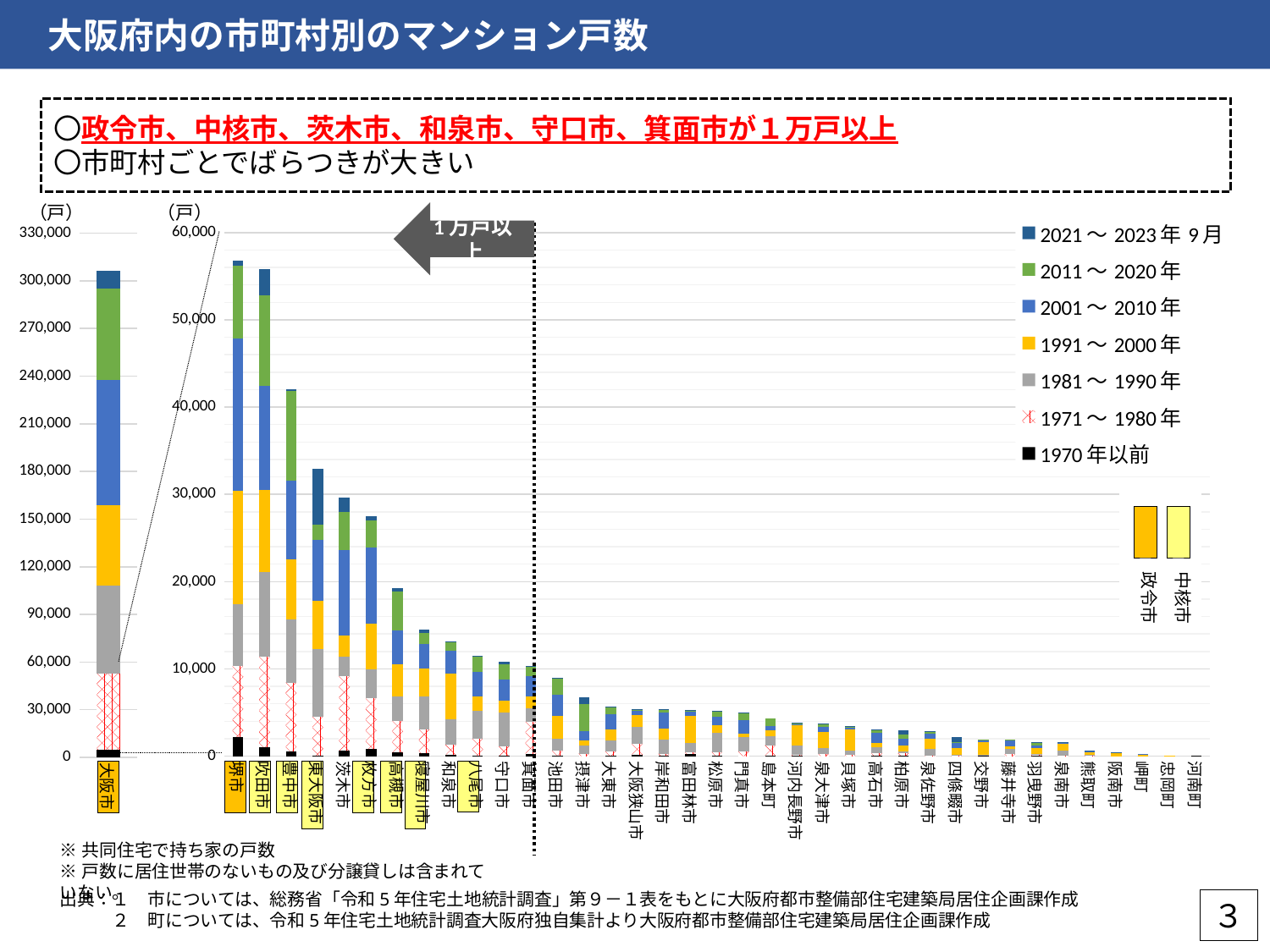
In the right-hand chart, which has the larger total, 東大阪市 or 茨木市? 東大阪市 In the left-hand chart, is the total for 大阪市 greater or less than 270,000? greater Which municipality has the highest total number of condominium units on the slide? 大阪市 What kind of chart is used on this slide to show the number of condominium units by municipality? bar chart In the right-hand chart, do the totals rise or fall moving from left to right along the x axis? fall In the right-hand chart, how many municipalities are shown to the left of the dashed line marking 1万戸以上? 12 In the right-hand chart (60,000 axis), which municipality has the lowest total? 河南町 In the right-hand chart, which has the larger total, 堺市 or 豊中市? 堺市 How many series (construction periods) does the legend list? 7 In the right-hand chart, is the total for 高槻市 greater or less than 20,000? less In the right-hand chart, is the total for 堺市 greater or less than 50,000? greater